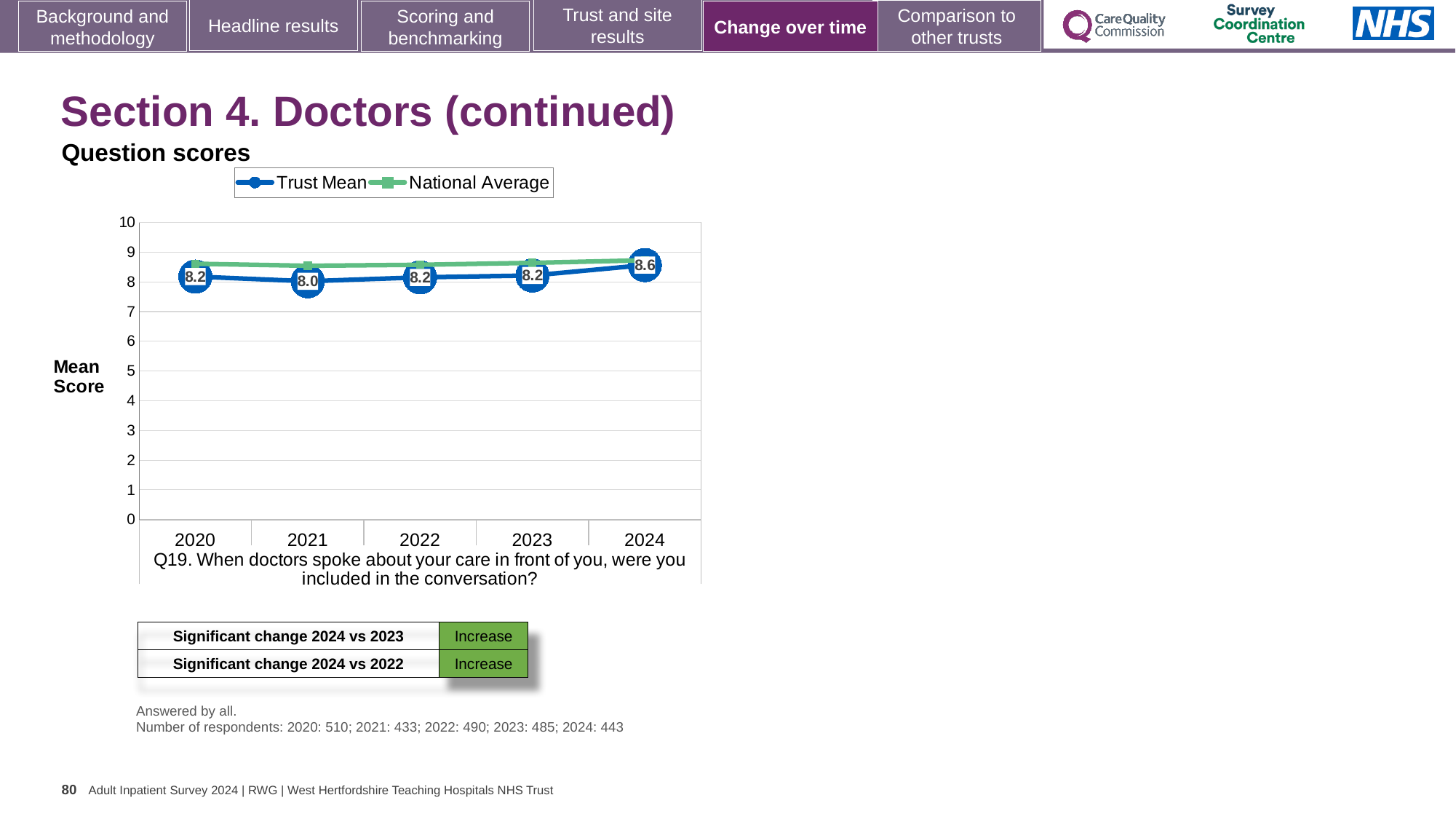
In which year is the Trust Mean highest? 2024 In which year is the Trust Mean lowest? 2021 Is the National Average value for 2020 greater or less than 8? greater What is the Trust Mean score for 2020? 8.2 Which is larger, the Trust Mean in 2024 or in 2023? 2024 How many series does the legend list? 2 What is the difference between the Trust Mean in 2024 and in 2021? 0.6 How many years are shown on the x axis? 5 Does the Trust Mean rise or fall from 2023 to 2024? Rise What is the Trust Mean score for 2024? 8.6 What is the Trust Mean score for 2021? 8.0 What kind of chart is shown? Line chart